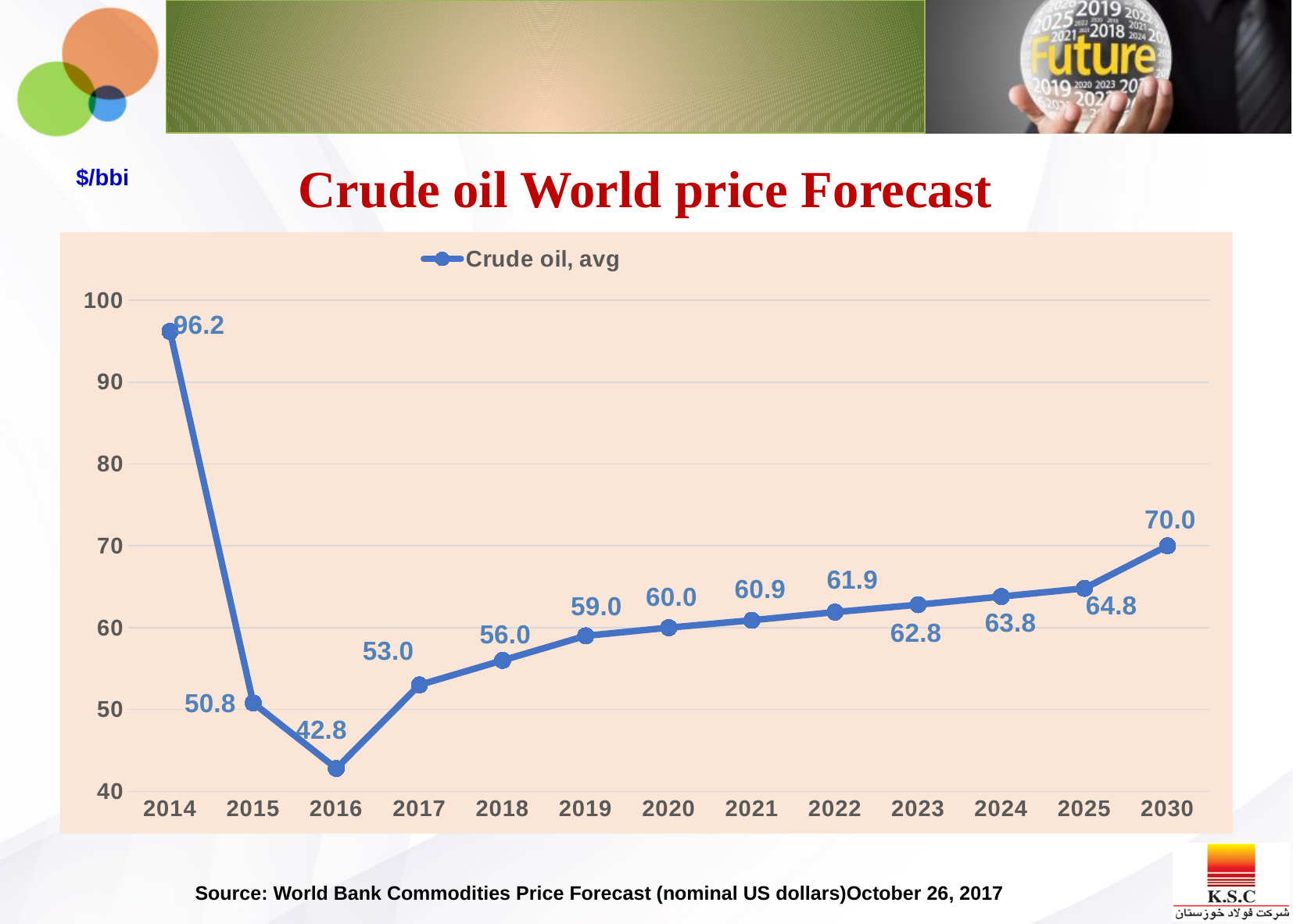
Do the crude oil prices rise or fall from 2016 to 2030? rise Which year has a higher crude oil price, 2019 or 2025? 2025 Is the crude oil price for 2022 greater or less than 60? greater What kind of chart is shown on the slide? line chart How many years are plotted on the x axis? 13 What is the difference between the crude oil price in 2014 and in 2015? 45.4 Which year has the highest crude oil average price on the chart? 2014 What is the crude oil average price forecast for 2016? 42.8 Which year has the lowest crude oil average price on the chart? 2016 What is the crude oil average price shown for 2014? 96.2 What is the crude oil average price forecast for 2030? 70.0 How many series does the legend list? 1